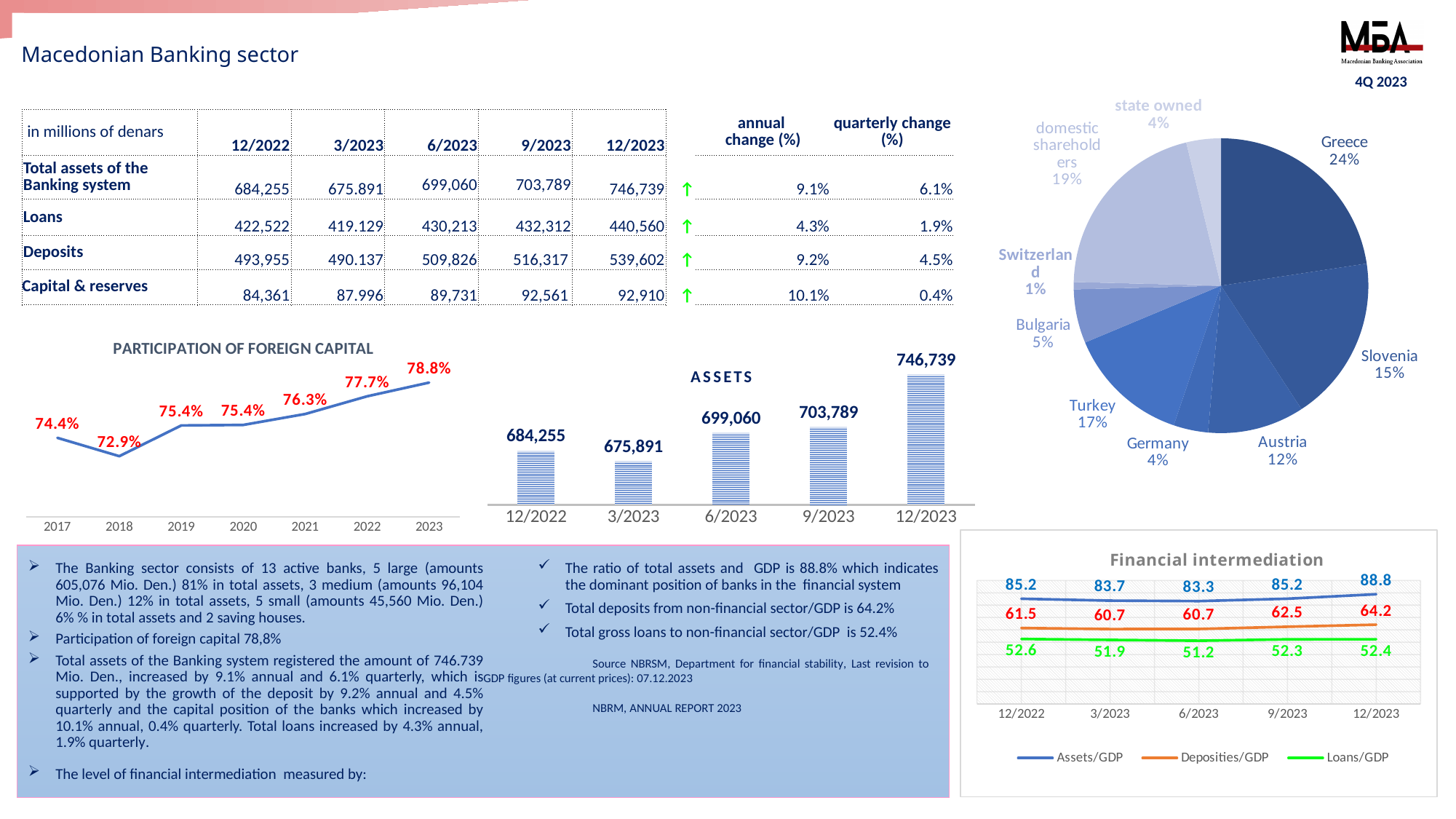
In the pie chart at the top right, which slice is the smallest? Switzerland In the PARTICIPATION OF FOREIGN CAPITAL chart, what is the difference between the 2023 and 2017 values? 4.4 percentage points In the PARTICIPATION OF FOREIGN CAPITAL chart, which year has the lowest value? 2018 In the PARTICIPATION OF FOREIGN CAPITAL chart, how many years are plotted? 7 How many series does the legend of the Financial intermediation chart list? 3 In the ASSETS chart, which period has the highest value? 12/2023 In the Financial intermediation chart, what is the Assets/GDP value for 12/2023? 88.8 In the ASSETS chart, what is the value for 9/2023? 703,789 In the ASSETS chart, what is the difference between the 12/2023 and 12/2022 values? 62,484 What kind of chart is the ASSETS chart? Bar chart In the pie chart at the top right, what share does Greece hold? 24% In the PARTICIPATION OF FOREIGN CAPITAL chart, what is the value for 2023? 78.8%